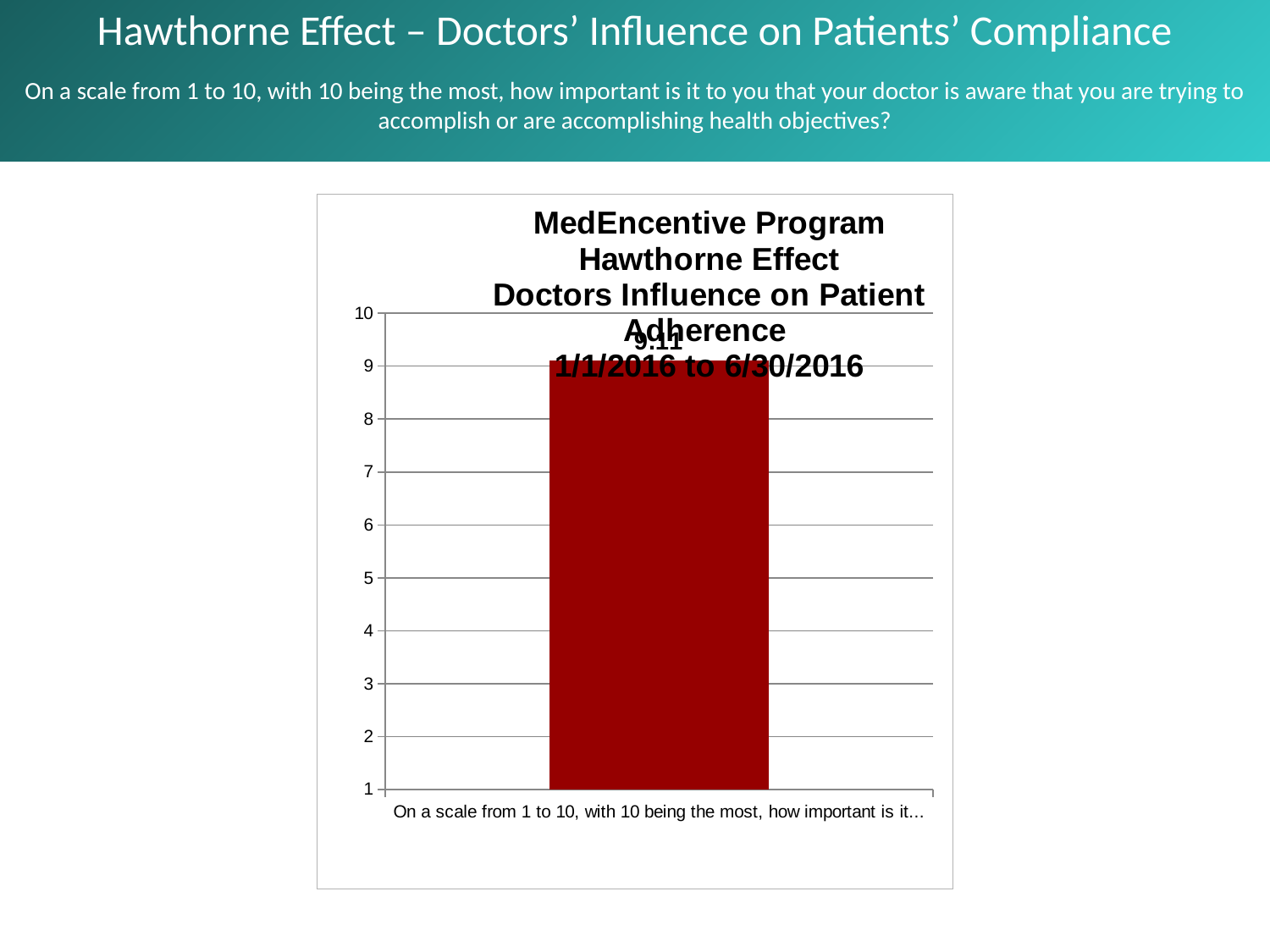
What kind of chart is shown on the slide? bar chart What is the lowest value shown on the vertical axis of the chart? 1 What colour is the bar in the chart? dark red Is the value of the bar greater or less than 10? less What date range is given in the chart title? 1/1/2016 to 6/30/2016 What is the value shown on the bar in the chart? 9.11 What is the highest value shown on the vertical axis of the chart? 10 How many bars are plotted in the chart? 1 Is the value of the bar greater or less than 8? greater Is the value of the bar greater or less than 5? greater